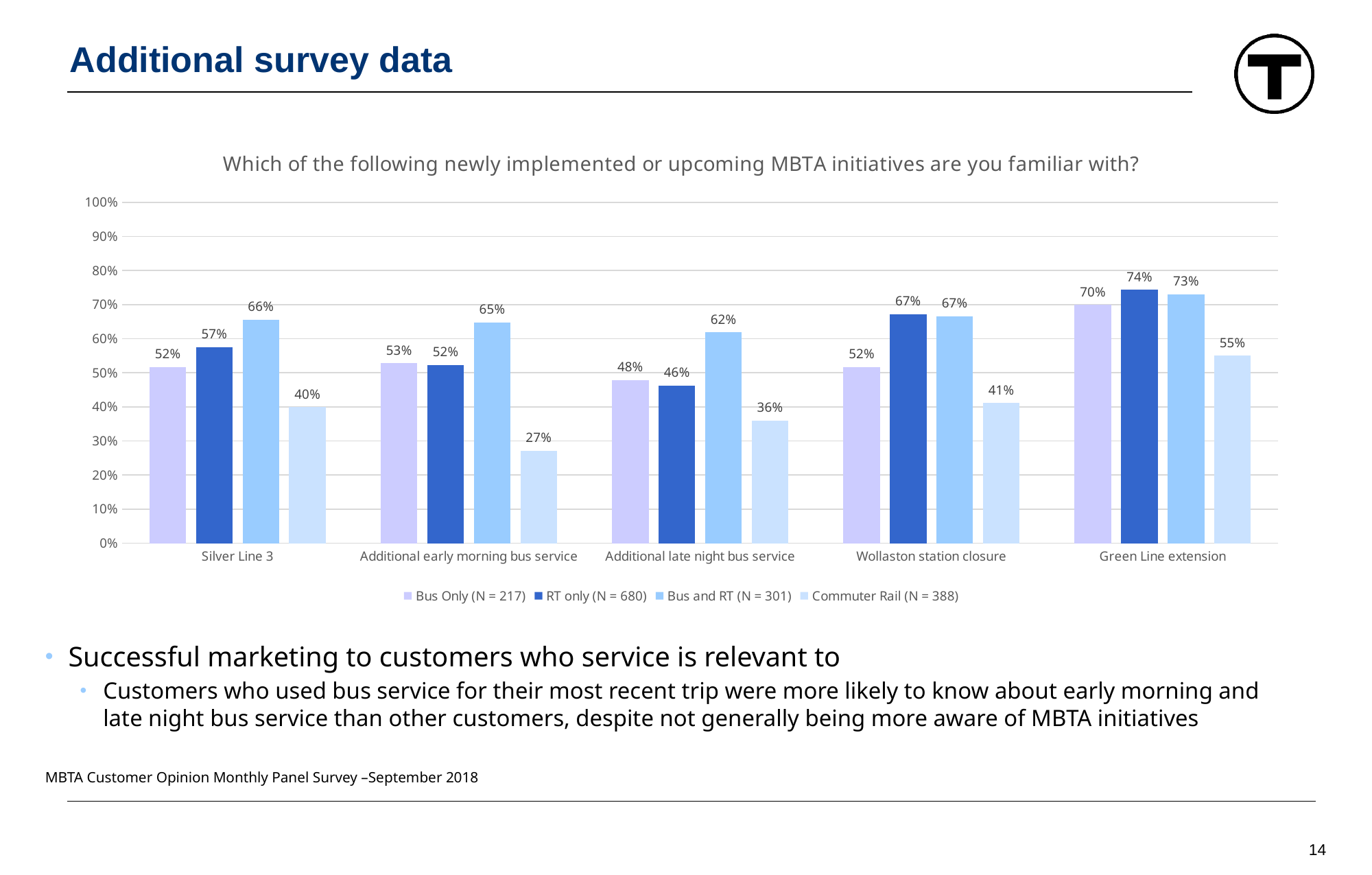
Which initiative has the highest familiarity among Bus Only (N = 217) respondents? Green Line extension What kind of chart is shown on the slide? Bar chart How many initiatives are shown on the x axis? 5 What is the value for RT only (N = 680) for Green Line extension? 74% For Wollaston station closure, which is larger: the Bus Only (N = 217) value or the RT only (N = 680) value? RT only (N = 680) How many series does the legend list? 4 Which initiative has the lowest familiarity among Commuter Rail (N = 388) respondents? Additional early morning bus service What is the title of the chart? Which of the following newly implemented or upcoming MBTA initiatives are you familiar with? What is the value for Bus and RT (N = 301) for Silver Line 3? 66% What is the total of the four series values for Silver Line 3? 215% What percentage of Commuter Rail (N = 388) respondents were familiar with Additional early morning bus service? 27% What is the difference between the Bus and RT (N = 301) and Commuter Rail (N = 388) values for Additional late night bus service? 26%